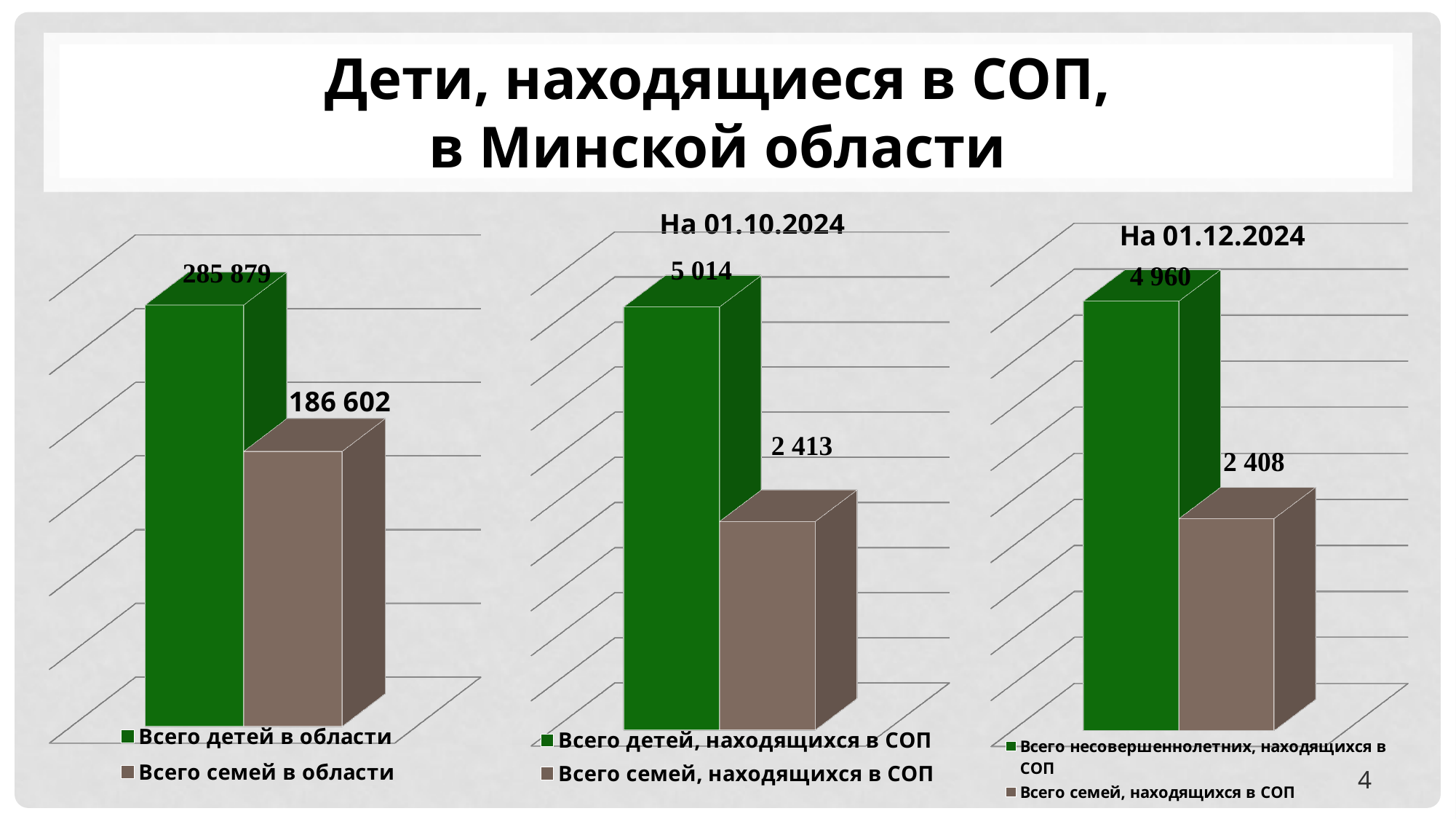
In the chart titled "На 01.12.2024", what is the value for "Всего несовершеннолетних, находящихся в СОП"? 4 960 In the chart titled "На 01.12.2024", what is the difference between the two plotted values? 2 552 What kind of chart is the chart titled "На 01.12.2024"? Bar chart In the chart titled "На 01.10.2024", what is the value for "Всего семей, находящихся в СОП"? 2 413 In the chart titled "На 01.12.2024", which series has the smaller value? Всего семей, находящихся в СОП In the left chart, which series has the larger value? Всего детей в области In the chart titled "На 01.12.2024", what is the value for "Всего семей, находящихся в СОП"? 2 408 In the left chart, what is the value for "Всего семей в области"? 186 602 In the chart titled "На 01.10.2024", what is the difference between the two plotted values? 2 601 In the chart titled "На 01.10.2024", what is the value for "Всего детей, находящихся в СОП"? 5 014 In the left chart, what is the value for "Всего детей в области"? 285 879 How many series does the legend of the chart titled "На 01.10.2024" list? 2